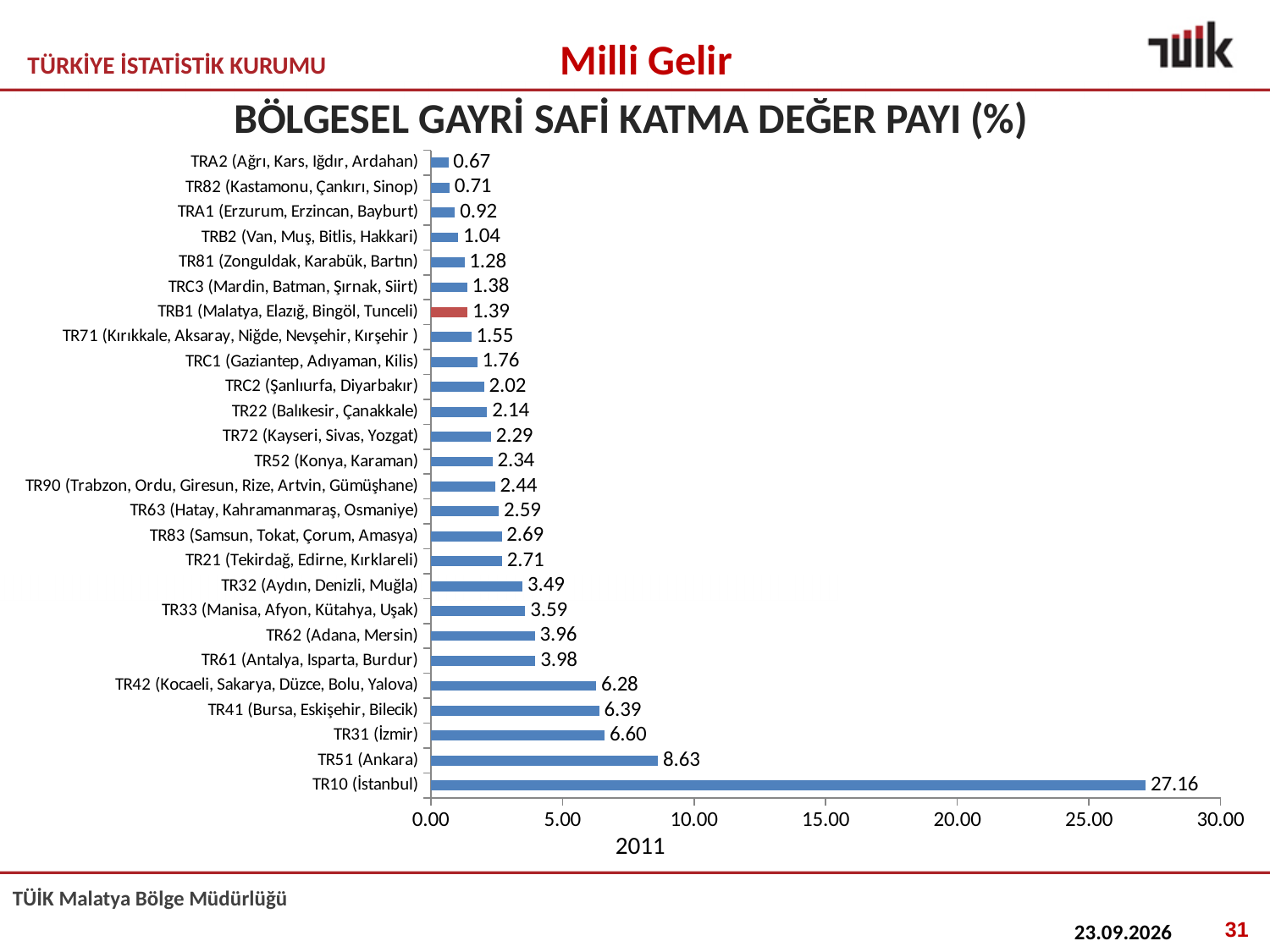
How many regions are shown in the chart? 26 What is the value for TRB1 (Malatya, Elazığ, Bingöl, Tunceli)? 1.39 Which region has the highest value? TR10 (İstanbul) Which is larger, the value for TR42 (Kocaeli, Sakarya, Düzce, Bolu, Yalova) or TR31 (İzmir)? TR31 (İzmir) What is the difference between the values for TR10 (İstanbul) and TR51 (Ankara)? 18.53 What is the value for TR51 (Ankara)? 8.63 What is the title of the chart? BÖLGESEL GAYRİ SAFİ KATMA DEĞER PAYI (%) Which region has the lowest value? TRA2 (Ağrı, Kars, Iğdır, Ardahan) Which region's bar is shown in a different colour (red) from the others? TRB1 (Malatya, Elazığ, Bingöl, Tunceli) What kind of chart is shown on the slide? bar chart What is the value for TR10 (İstanbul)? 27.16 Is the value for TR51 (Ankara) greater or less than 10.00? less